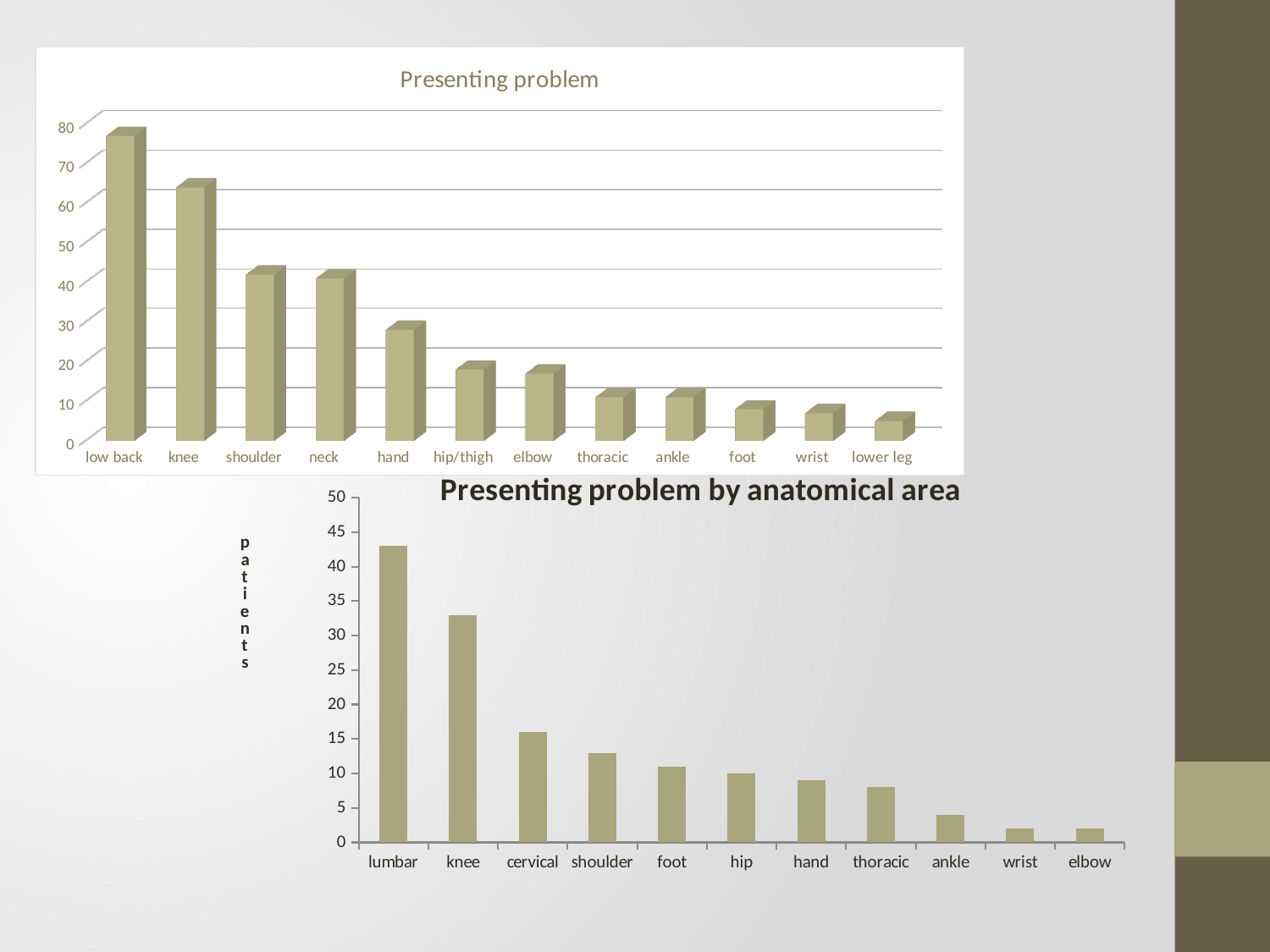
How many categories are shown in the bottom chart titled 'Presenting problem by anatomical area'? 11 In the bottom chart titled 'Presenting problem by anatomical area', which category has the highest value? lumbar In the bottom chart titled 'Presenting problem by anatomical area', is the value for ankle greater or less than 5? less How many categories are shown in the top chart titled 'Presenting problem'? 12 In the top chart titled 'Presenting problem', which category has the highest value? low back In the top chart titled 'Presenting problem', is the value for low back greater or less than 70? greater What is the label on the vertical axis of the bottom chart titled 'Presenting problem by anatomical area'? patients In the top chart titled 'Presenting problem', which category has the lowest value? lower leg What kind of chart is the top chart titled 'Presenting problem'? bar chart In the top chart titled 'Presenting problem', is the value for hand greater or less than 30? less In the top chart titled 'Presenting problem', which is larger, the value for knee or the value for shoulder? knee